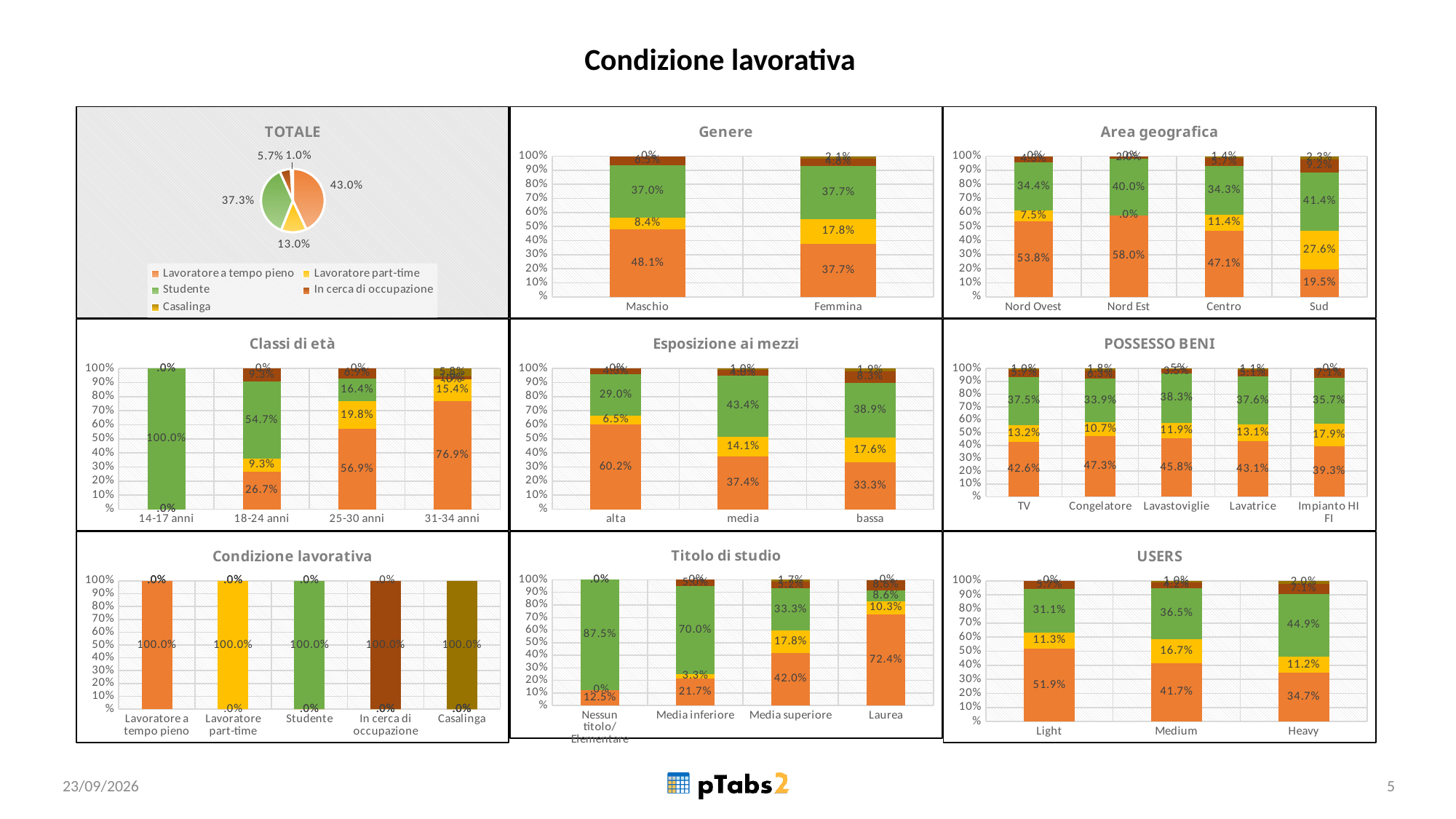
In the POSSESSO BENI chart, what is the Lavoratore part-time value for Impianto HI FI? 17.9% In the TOTALE pie chart, what share is shown for Studente? 37.3% In the Area geografica chart, which region has the lowest Lavoratore a tempo pieno value? Sud In the Genere chart, what is the Lavoratore a tempo pieno value for Maschio? 48.1% In the Esposizione ai mezzi chart, how many categories are shown on the x axis? 3 In the Genere chart, what is the Lavoratore part-time value for Femmina? 17.8% In the USERS chart, what is the Studente value for Heavy? 44.9% In the TOTALE pie chart, what share is shown for Lavoratore a tempo pieno? 43.0% In the Classi di età chart, what is the Studente value for 18-24 anni? 54.7% In the Esposizione ai mezzi chart, is the Lavoratore a tempo pieno value for alta larger or smaller than for bassa? larger In the Titolo di studio chart, what is the Lavoratore a tempo pieno value for Laurea? 72.4% In the Area geografica chart, what is the difference between the Lavoratore a tempo pieno values for Nord Est and Nord Ovest? 4.2%